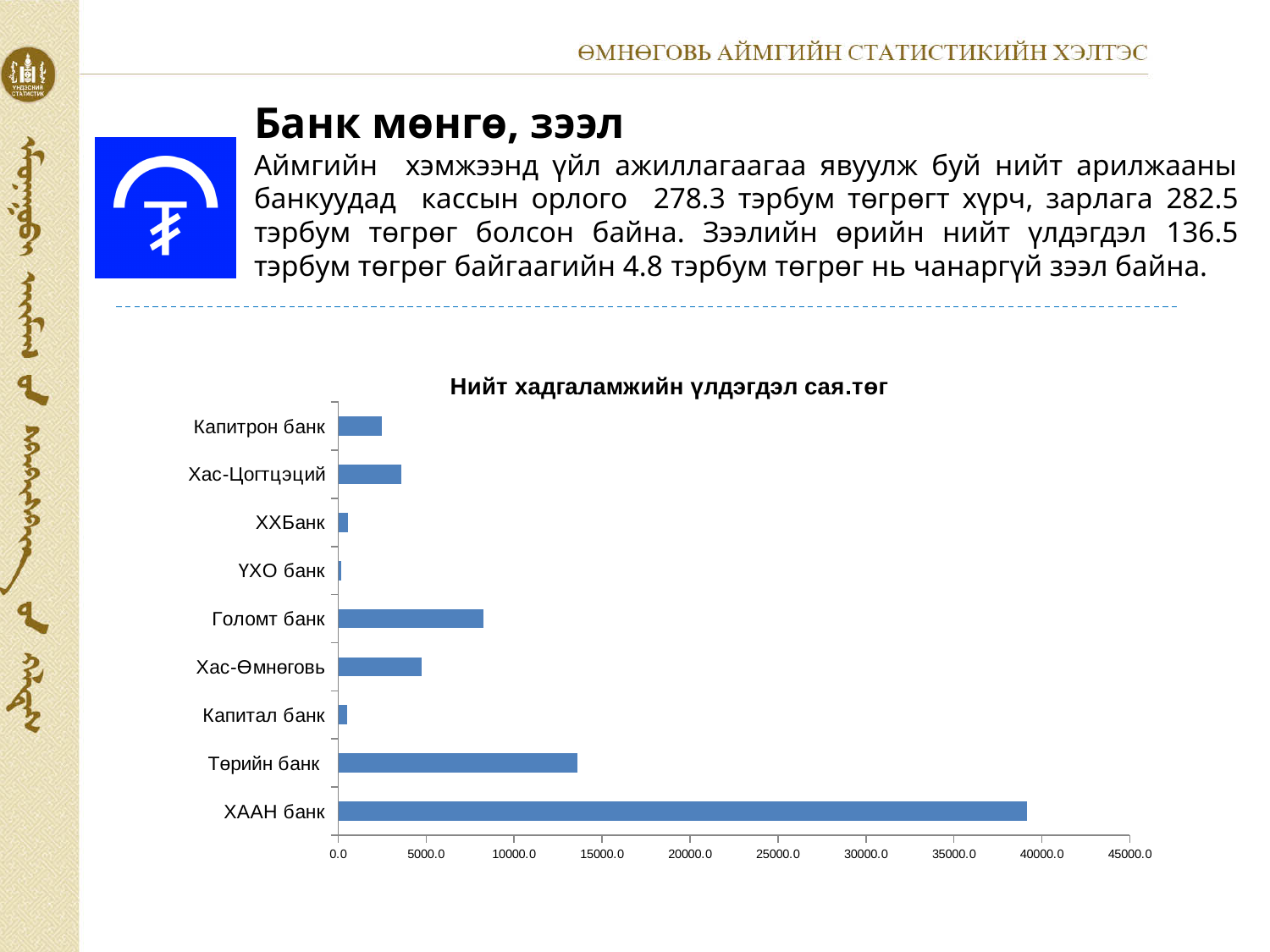
Which has a larger value, Хас-Цогтцэций or Капитрон банк? Хас-Цогтцэций Is the value for ХААН банк greater or less than 35000.0? greater Which bank has the highest value in the chart? ХААН банк What kind of chart is shown on the slide? bar chart Which has a larger value, Төрийн банк or Голомт банк? Төрийн банк Is the value for Төрийн банк greater or less than 10000.0? greater Is the value for Голомт банк greater or less than 10000.0? less How many banks are shown in the chart? 9 What is the title of the chart? Нийт хадгаламжийн үлдэгдэл сая.төг Which bank has the lowest value in the chart? ҮХО банк